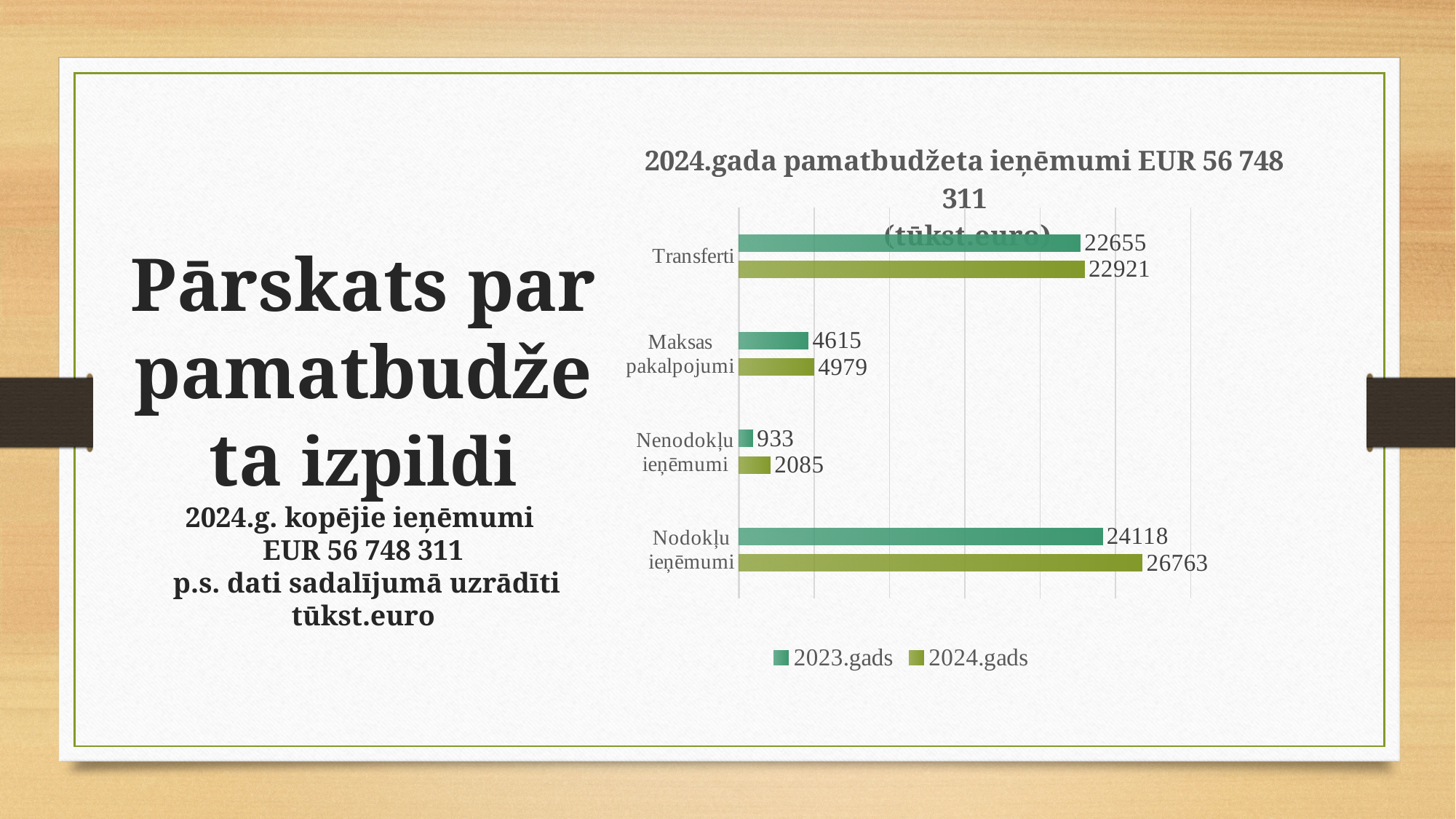
What are the two series named in the legend? 2023.gads and 2024.gads What is the 2023.gads value for Transferti? 22655 Which is larger for Nenodokļu ieņēmumi: the 2023.gads value or the 2024.gads value? 2024.gads Which category has the highest 2024.gads value? Nodokļu ieņēmumi Which category has the lowest 2023.gads value? Nenodokļu ieņēmumi What is the difference between the 2024.gads and 2023.gads values for Nodokļu ieņēmumi? 2645 What is the 2024.gads value for Nenodokļu ieņēmumi? 2085 How many series does the legend list? 2 How many categories are shown on the chart? 4 What is the 2023.gads value for Maksas pakalpojumi? 4615 What kind of chart is shown on the slide? Bar chart What is the 2024.gads value for Nodokļu ieņēmumi? 26763